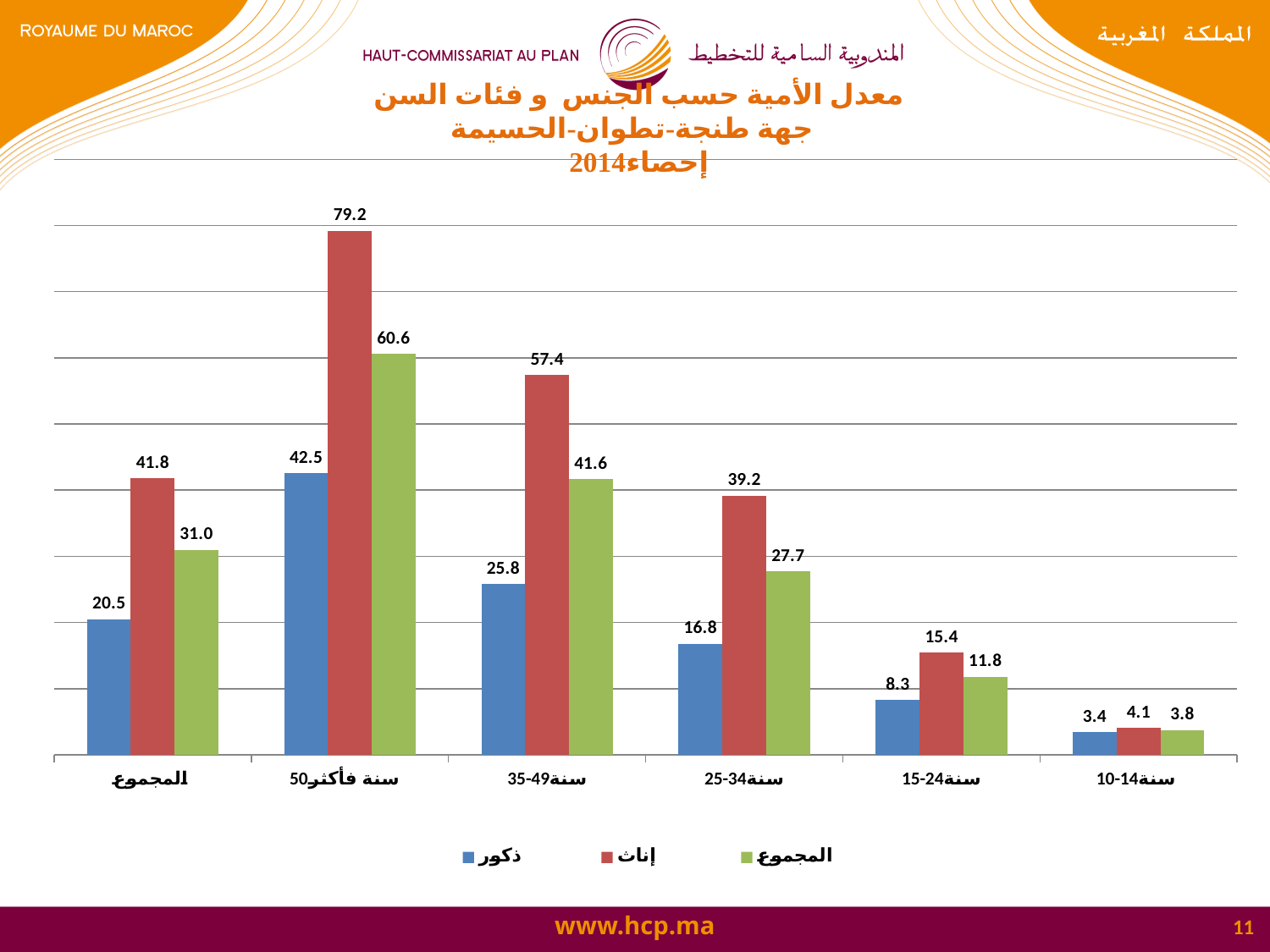
How many series does the legend list? 3 What is the value for ذكور (males) in the المجموع (overall) category? 20.5 Which age group has the lowest value for ذكور (males)? 10-14 سنة Which age group has the highest value for إناث (females)? 50 سنة فأكثر What is the difference between the إناث (females) and ذكور (males) values in the 50 سنة فأكثر age group? 36.7 What is the value for المجموع (total) in the 25-34 سنة age group? 27.7 How many age-group categories (including المجموع) are shown on the x axis? 6 Which is larger in the 15-24 سنة age group: the value for إناث (females) or for المجموع (total)? إناث (females) What kind of chart is shown on the slide? Bar chart What is the value for ذكور (males) in the 35-49 سنة age group? 25.8 Which colour represents the إناث (females) series in the chart? Red What is the value for إناث (females) in the 50 سنة فأكثر age group? 79.2